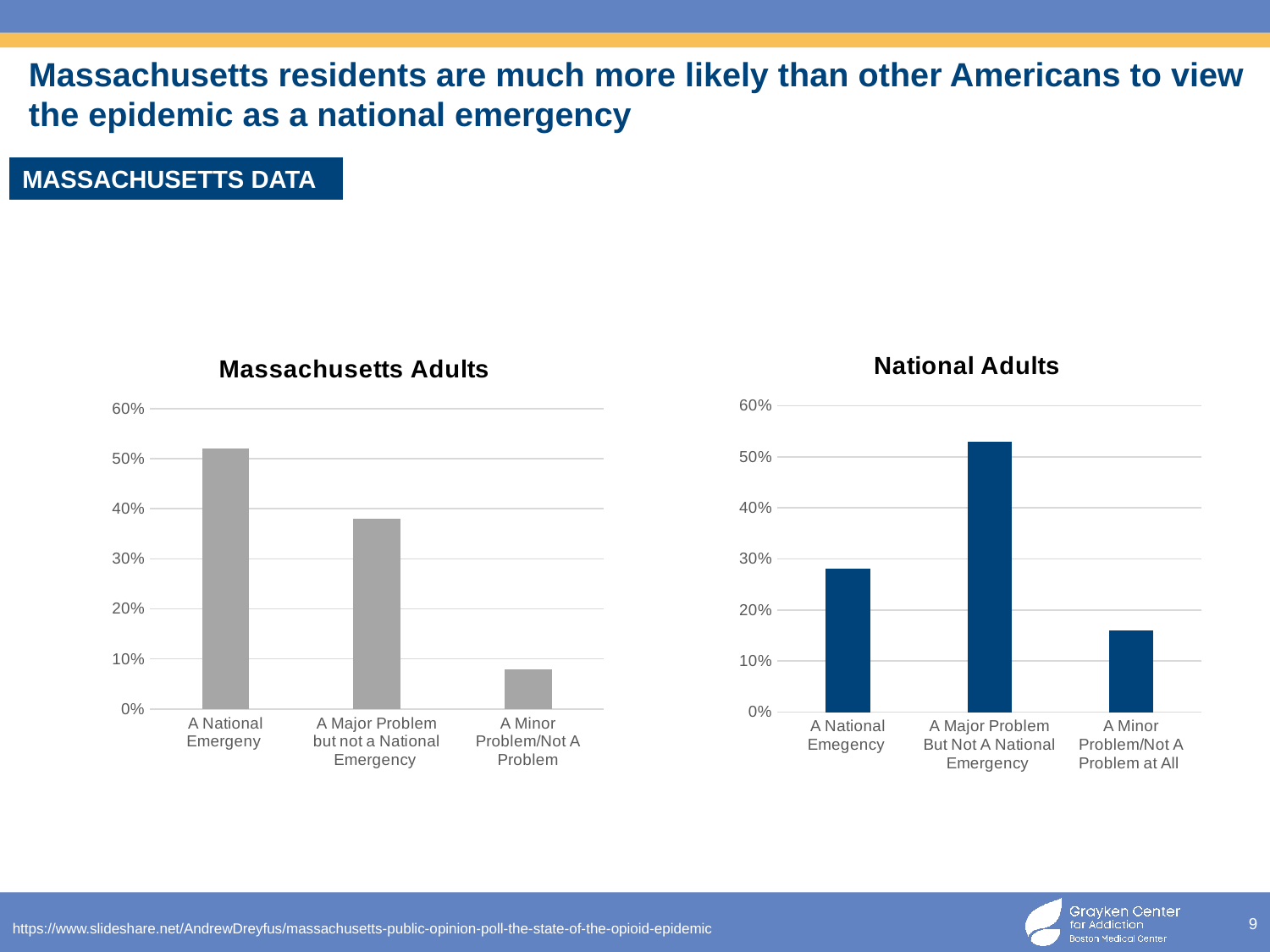
What kind of chart is the National Adults chart? Bar chart In the National Adults chart, is the value for A Major Problem But Not A National Emergency greater or less than 50%? greater In the National Adults chart, which category has the highest bar? A Major Problem But Not A National Emergency In the National Adults chart, is the value for A National Emegency greater or less than 30%? less In the National Adults chart, which is larger: A National Emegency or A Minor Problem/Not A Problem at All? A National Emegency In the Massachusetts Adults chart, do the values rise or fall from left to right across the categories? Fall How many categories are shown in the Massachusetts Adults chart? 3 In the Massachusetts Adults chart, is the value for A National Emergeny greater or less than 50%? greater In the Massachusetts Adults chart, which category has the highest bar? A National Emergeny In the Massachusetts Adults chart, which category has the lowest bar? A Minor Problem/Not A Problem In the National Adults chart, which category has the lowest bar? A Minor Problem/Not A Problem at All